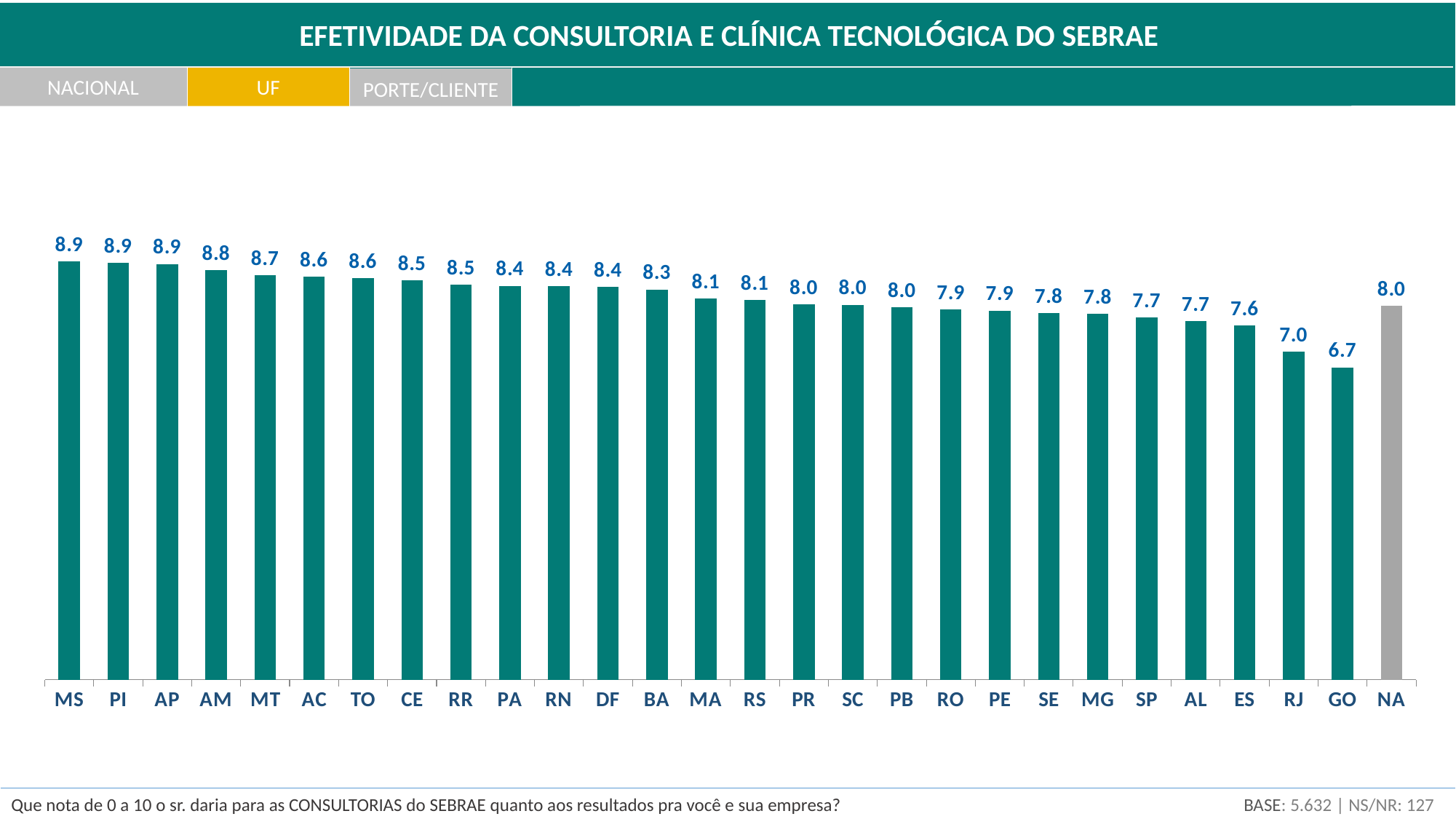
What is the value for MS? 8.9 How many categories are shown on the x axis? 28 What is the value for BA? 8.3 Which bar is coloured grey instead of teal? NA What is the value for NA? 8.0 Which is larger, the value for RJ or the value for GO? RJ What kind of chart is shown on the slide? bar chart What is the difference between the values for MS and GO? 2.2 Which category has the lowest value? GO What is the value for RJ? 7.0 Which is larger, the value for MT or the value for SP? MT What is the difference between the values for AM and ES? 1.2